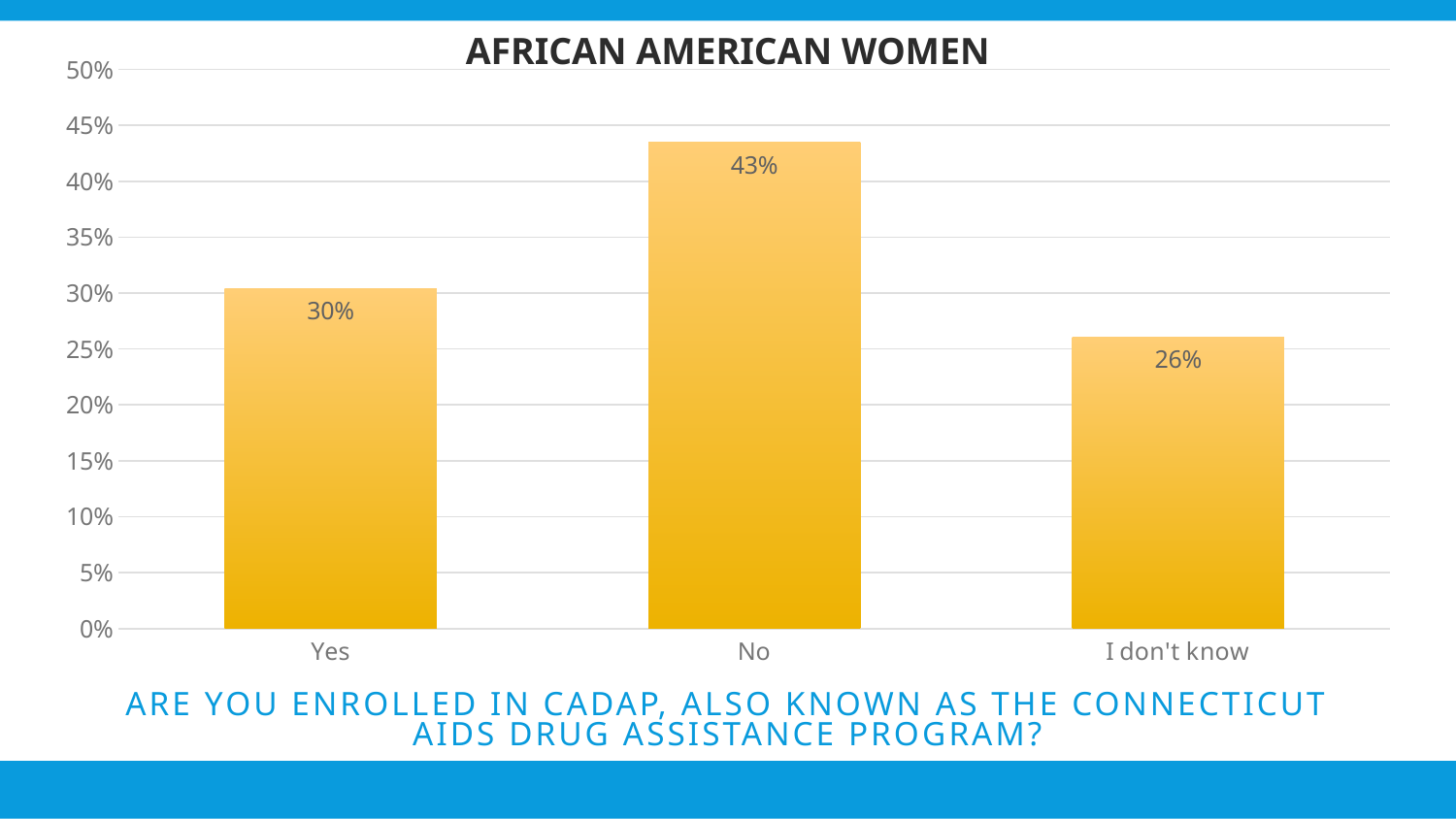
What is the difference between the "No" and "Yes" values? 13% What percentage of respondents answered "No"? 43% Is the value for "No" greater or less than 40%? greater What is the difference between the "Yes" and "I don't know" values? 4% Which response category has the lowest value? I don't know What percentage of respondents answered "I don't know"? 26% What is the title of the chart? AFRICAN AMERICAN WOMEN What kind of chart is shown on the slide? Bar chart How many response categories are shown on the chart? 3 What percentage of respondents answered "Yes"? 30% Which response category has the highest value? No Which is larger, the value for "Yes" or the value for "I don't know"? Yes